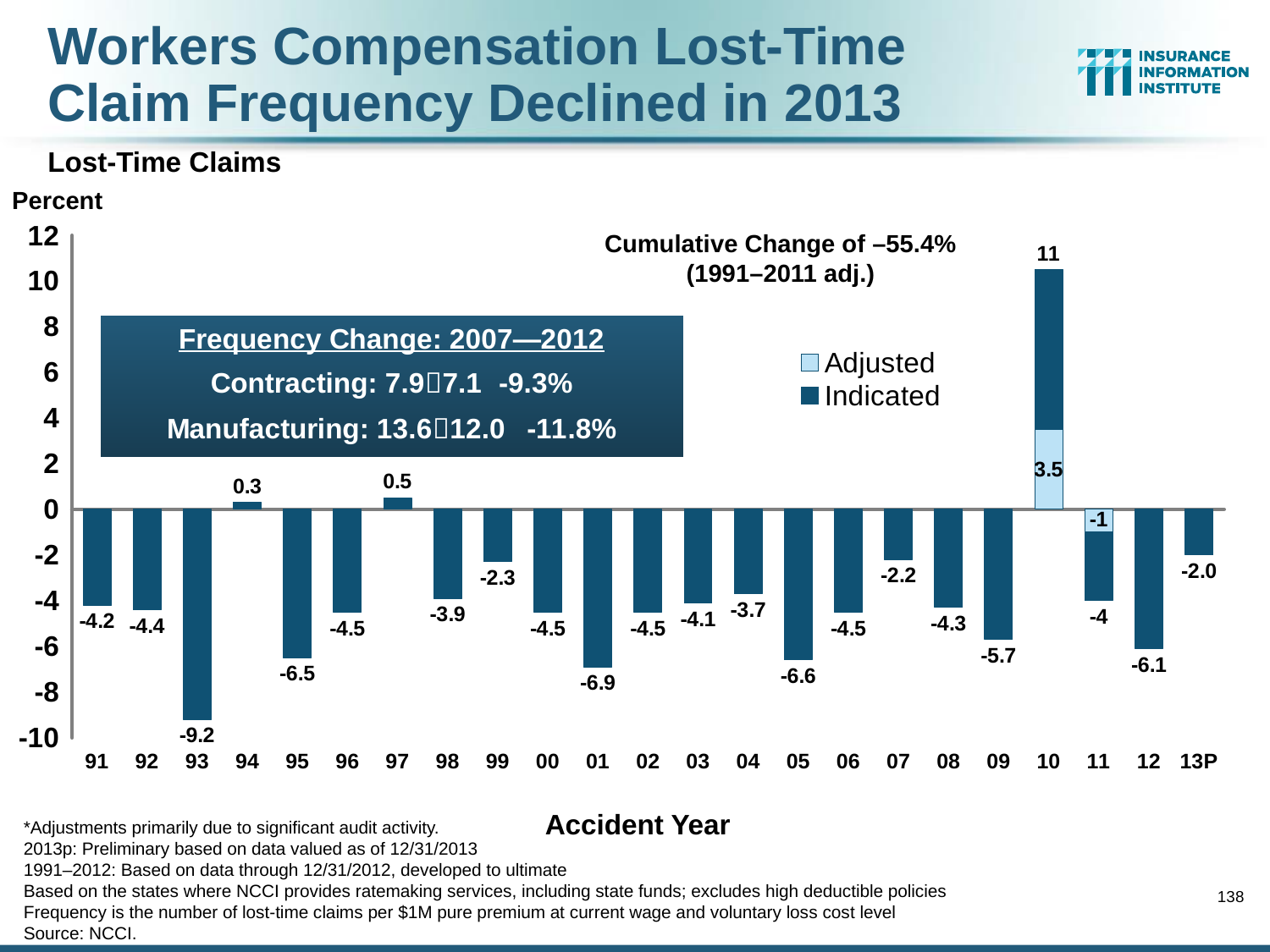
What is the Adjusted value for accident year 11? -1 Which accident year has the highest value? 10 What kind of chart is shown on the slide? Bar chart What is the value for accident year 13P? -2.0 What is the difference between the values for accident years 12 and 13P? 4.1 Which accident year has the lowest value? 93 How many series does the legend list? 2 What is the Adjusted value for accident year 10? 3.5 What is the value for accident year 93? -9.2 What cumulative change for 1991–2011 (adj.) is stated on the chart? –55.4% Which is larger, the value for accident year 98 or accident year 99? 99 What is the Indicated value for accident year 10? 11